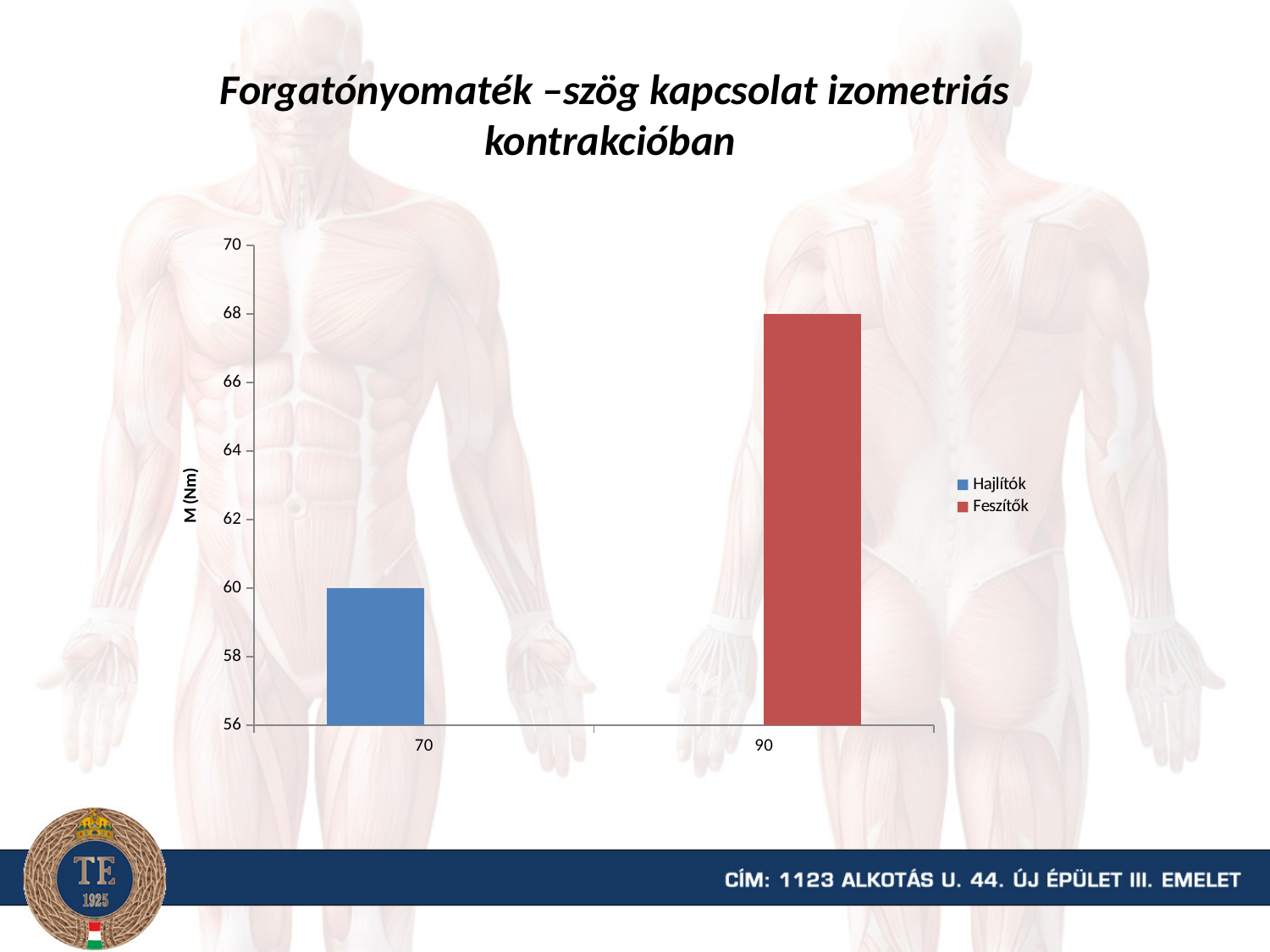
Which category has the highest bar? 90 What is the label of the vertical axis? M (Nm) What is the value of the Feszítők bar at 90? 68 Which series has the higher bar, Hajlítók or Feszítők? Feszítők Is the value for Hajlítók greater or less than 62? less How many series does the legend list? 2 How many bars are plotted in the chart? 2 Is the value for Feszítők greater or less than 66? greater What kind of chart is shown on the slide? Bar chart What is the value of the Hajlítók bar at 70? 60 Which category has the lowest bar? 70 What is the difference between the Feszítők value and the Hajlítók value? 8